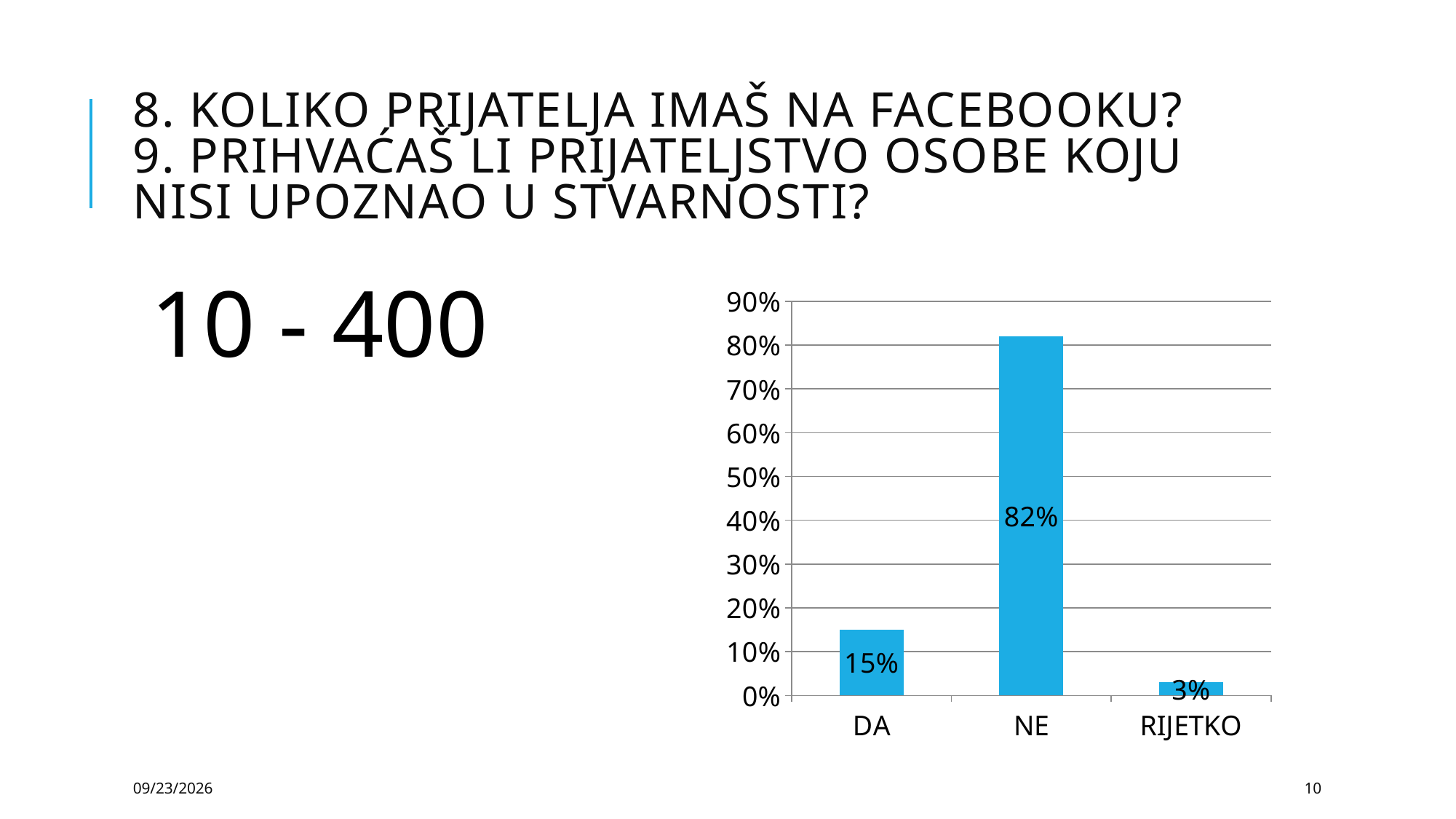
What is the value for NE? 82% How many categories are shown on the x axis? 3 What is the value for DA? 15% Which category has the lowest value? RIJETKO What is the difference between the values for DA and RIJETKO? 12% What is the highest value shown on the vertical axis? 90% Which category has the highest value? NE What is the difference between the values for NE and DA? 67% Is the value for NE greater or less than 80%? greater Which is larger, the value for DA or the value for RIJETKO? DA What kind of chart is shown on the slide? bar chart What is the value for RIJETKO? 3%